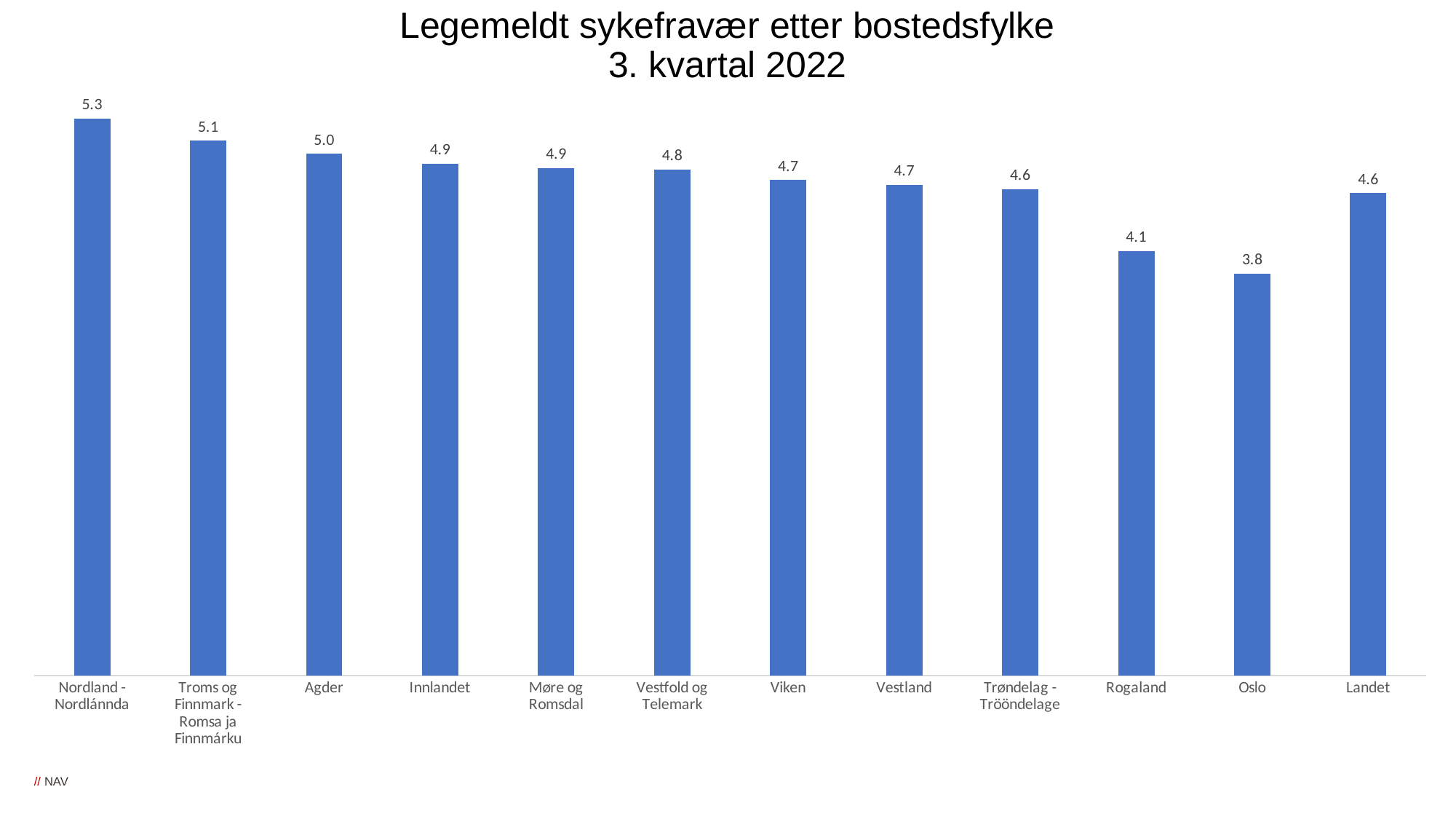
What is the value for Landet? 4.6 What is the value for Rogaland? 4.1 What is the difference between the values for Nordland - Nordlánnda and Oslo? 1.5 How many categories are shown on the x axis? 12 What is the value for Agder? 5.0 Which is larger, the value for Innlandet or the value for Rogaland? Innlandet What is the title of the chart? Legemeldt sykefravær etter bostedsfylke 3. kvartal 2022 Which category has the highest value? Nordland - Nordlánnda What is the value for Oslo? 3.8 What is the difference between the values for Agder and Rogaland? 0.9 Which category has the lowest value? Oslo What kind of chart is this? Bar chart